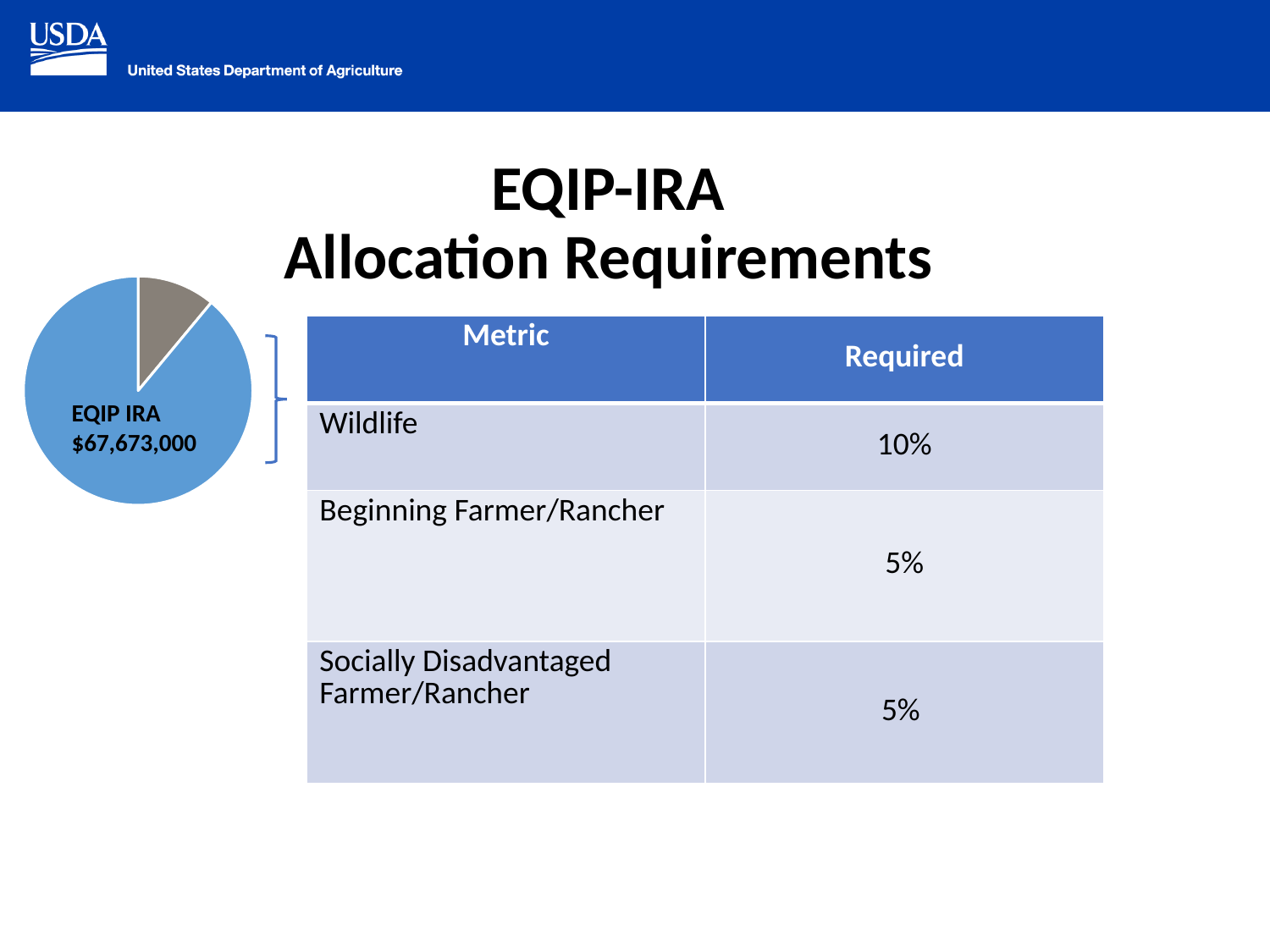
How many slices does the pie chart have? 2 What dollar value is printed on the EQIP IRA slice of the pie chart? $67,673,000 Which slice of the pie chart is the largest? EQIP IRA Does the EQIP IRA slice take up more or less than half of the pie chart? more What kind of chart is shown on the left of the slide? pie chart What colour is the EQIP IRA slice in the pie chart? blue In the pie chart, is the blue slice or the gray slice larger? the blue slice